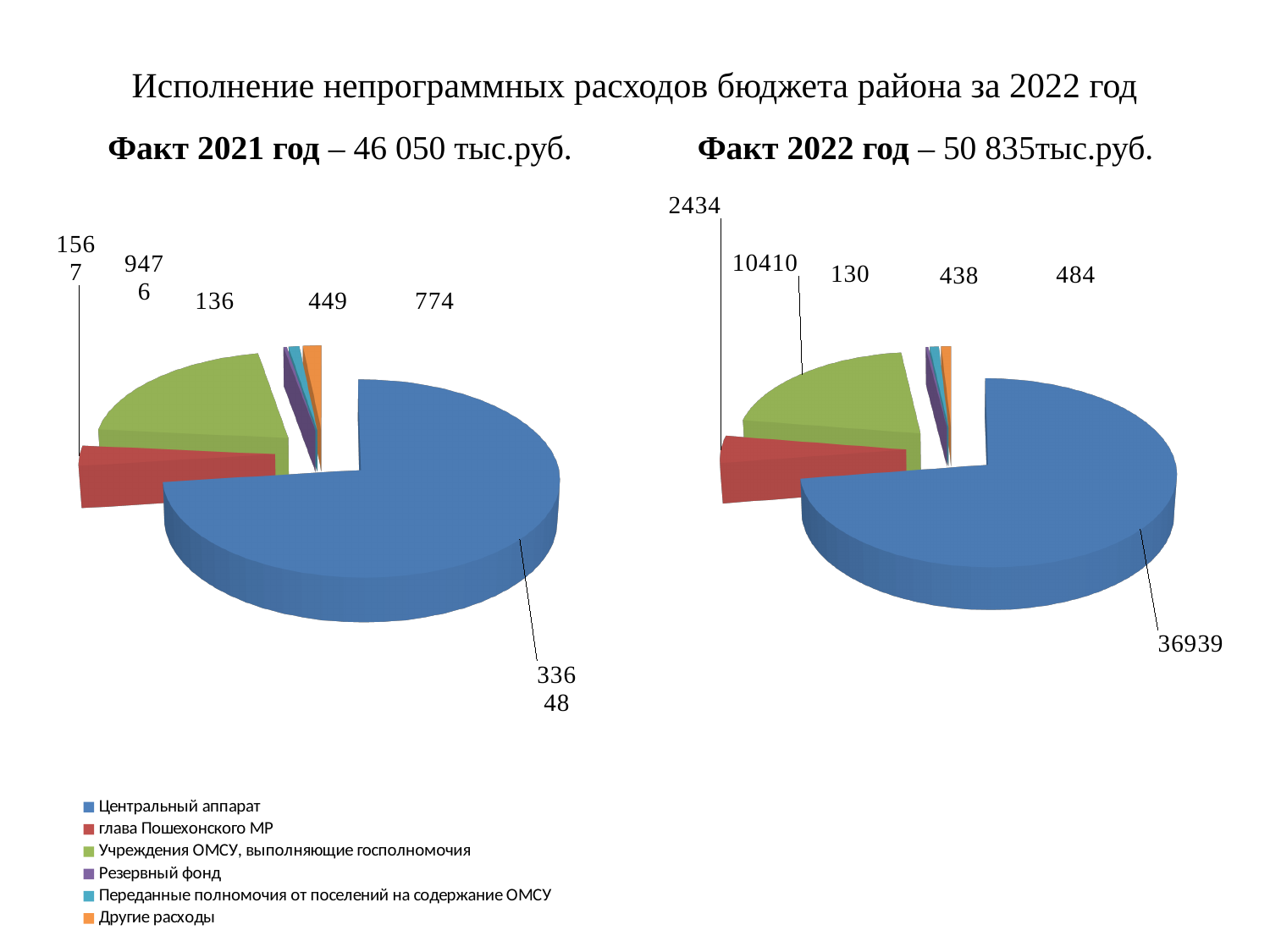
In the 2022 pie chart (Факт 2022 год), what is the value for Учреждения ОМСУ, выполняющие госполномочия? 10410 In the 2022 pie chart (Факт 2022 год), what is the value for глава Пошехонского МР? 2434 What is the difference between the Центральный аппарат value in the 2022 chart and in the 2021 chart? 3291 How many entries does the legend list? 6 In the 2021 pie chart (Факт 2021 год), what is the value for Центральный аппарат? 33648 How many slices does the 2022 pie chart (Факт 2022 год) have? 6 In the 2022 pie chart (Факт 2022 год), which category has the smallest slice? Резервный фонд In the 2021 pie chart (Факт 2021 год), what is the value for Другие расходы? 774 In the 2021 pie chart (Факт 2021 год), which is larger: Переданные полномочия от поселений на содержание ОМСУ or Резервный фонд? Переданные полномочия от поселений на содержание ОМСУ In the 2021 pie chart (Факт 2021 год), which category has the largest slice? Центральный аппарат What type of chart is used on this slide? Pie chart What is the total shown for Факт 2022 год? 50 835тыс.руб.